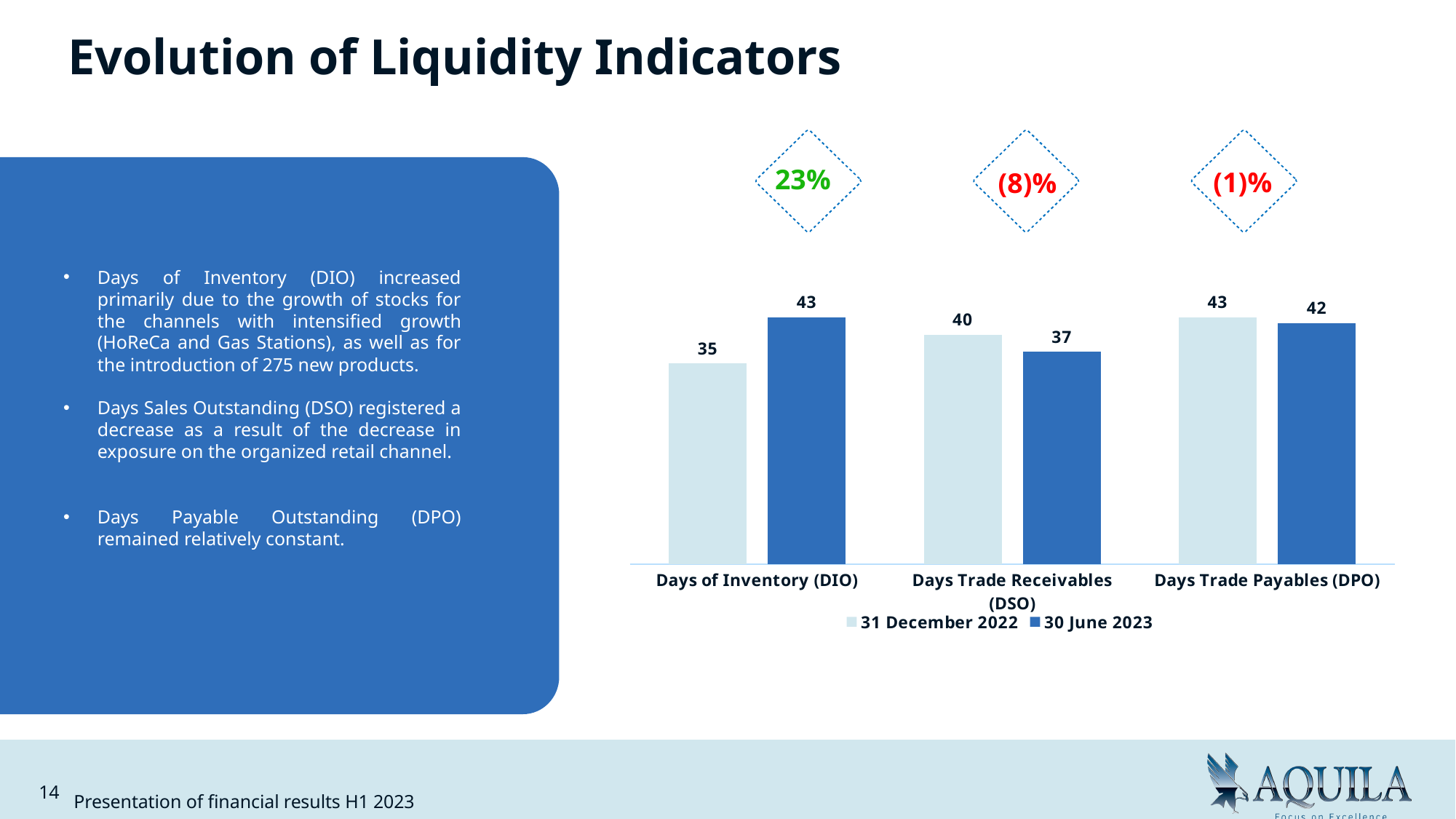
For Days Trade Payables (DPO), which is larger: the 31 December 2022 value or the 30 June 2023 value? 31 December 2022 What is the difference between the 30 June 2023 and 31 December 2022 values for Days of Inventory (DIO)? 8 How many categories are shown on the x axis of the chart? 3 What is the value for Days of Inventory (DIO) at 31 December 2022? 35 What is the value for Days Trade Payables (DPO) at 31 December 2022? 43 How many series does the chart legend list? 2 What kind of chart is shown on the slide? Bar chart Which category has the lowest value for 30 June 2023? Days Trade Receivables (DSO) Which category has the lowest value for 31 December 2022? Days of Inventory (DIO) What is the value for Days Trade Receivables (DSO) at 30 June 2023? 37 What is the difference between the 31 December 2022 and 30 June 2023 values for Days Trade Receivables (DSO)? 3 What is the value for Days of Inventory (DIO) at 30 June 2023? 43